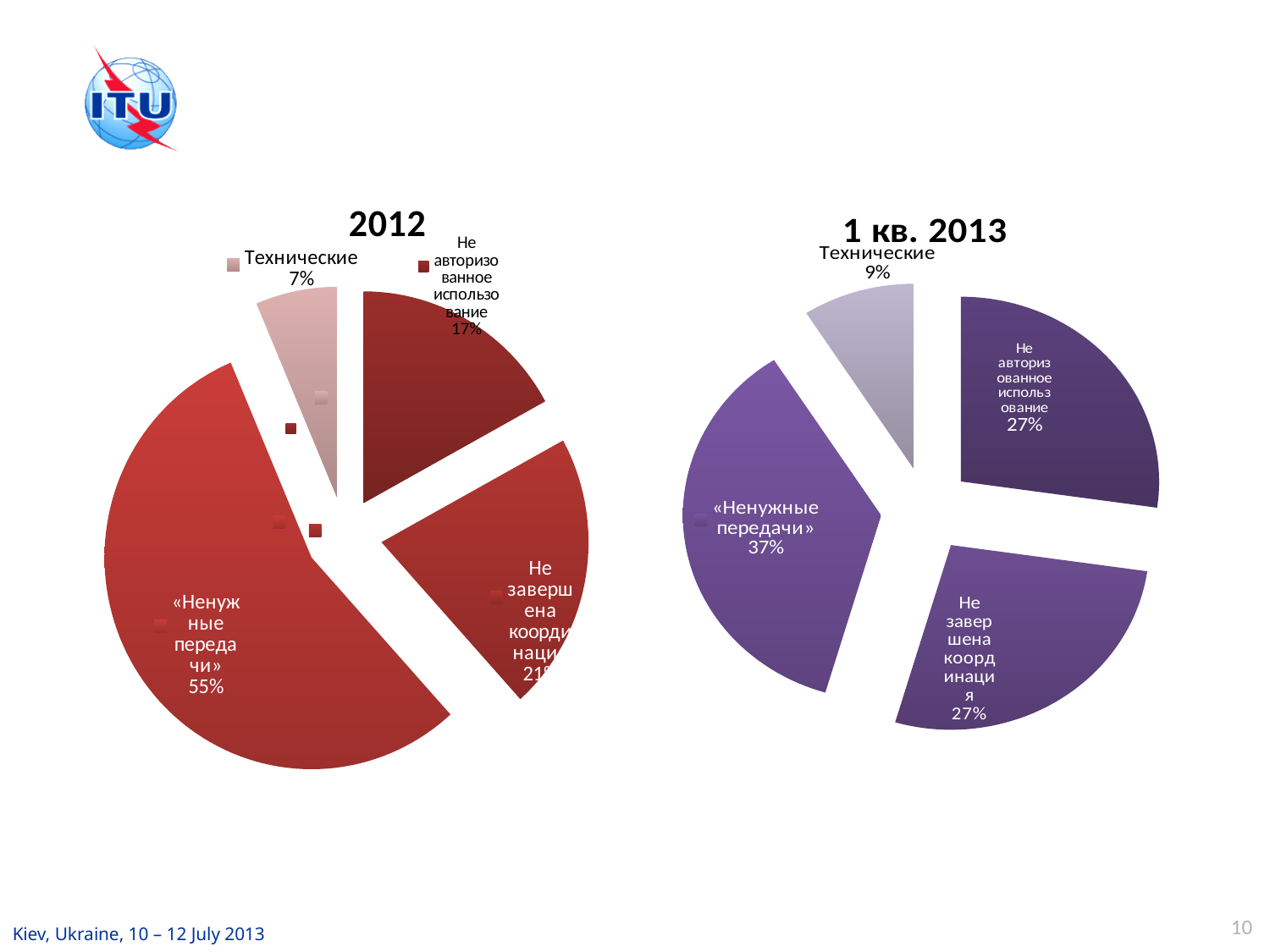
In the "2012" chart, which category has the smallest slice? Технические In the "2012" chart, what share is shown for Не авторизованное использование? 17% In the "2012" chart, which category has the largest slice? «Ненужные передачи» In the "2012" chart, what share is shown for Технические? 7% How many slices does the "1 кв. 2013" pie chart have? 4 In the "1 кв. 2013" chart, what share is shown for Не завершена координация? 27% In the "1 кв. 2013" chart, what share is shown for Технические? 9% In the "2012" chart, what is the difference in percentage points between «Ненужные передачи» and Не авторизованное использование? 38 percentage points In the "2012" chart, what share is shown for «Ненужные передачи»? 55% In the "1 кв. 2013" chart, what share is shown for «Ненужные передачи»? 37% What kind of chart is the chart titled "2012"? pie chart In the "1 кв. 2013" chart, which category has the largest slice? «Ненужные передачи»